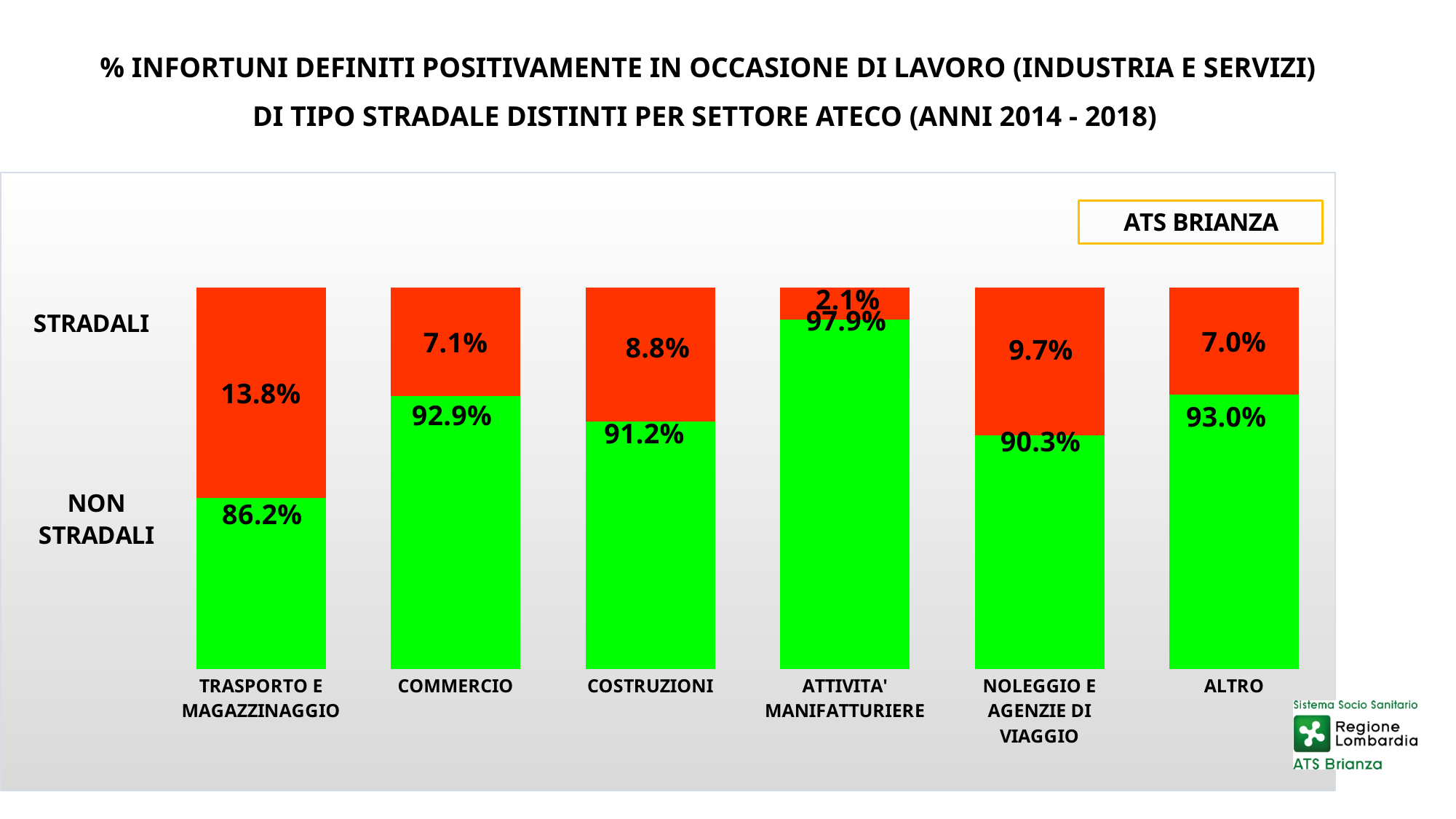
What is the total of the stacked bar for COSTRUZIONI? 100.0% Which is larger, the STRADALI value for ALTRO or for NOLEGGIO E AGENZIE DI VIAGGIO? NOLEGGIO E AGENZIE DI VIAGGIO What is the STRADALI value for TRASPORTO E MAGAZZINAGGIO? 13.8% Which sector has the lowest STRADALI share? ATTIVITA' MANIFATTURIERE What is the STRADALI value for NOLEGGIO E AGENZIE DI VIAGGIO? 9.7% How many sectors are shown on the x axis? 6 What is the difference between the STRADALI values for COSTRUZIONI and COMMERCIO? 1.7% How many series does the chart show? 2 What is the NON STRADALI value for COMMERCIO? 92.9% What is the NON STRADALI value for ATTIVITA' MANIFATTURIERE? 97.9% What kind of chart is this? Stacked bar chart Which sector has the highest STRADALI share? TRASPORTO E MAGAZZINAGGIO